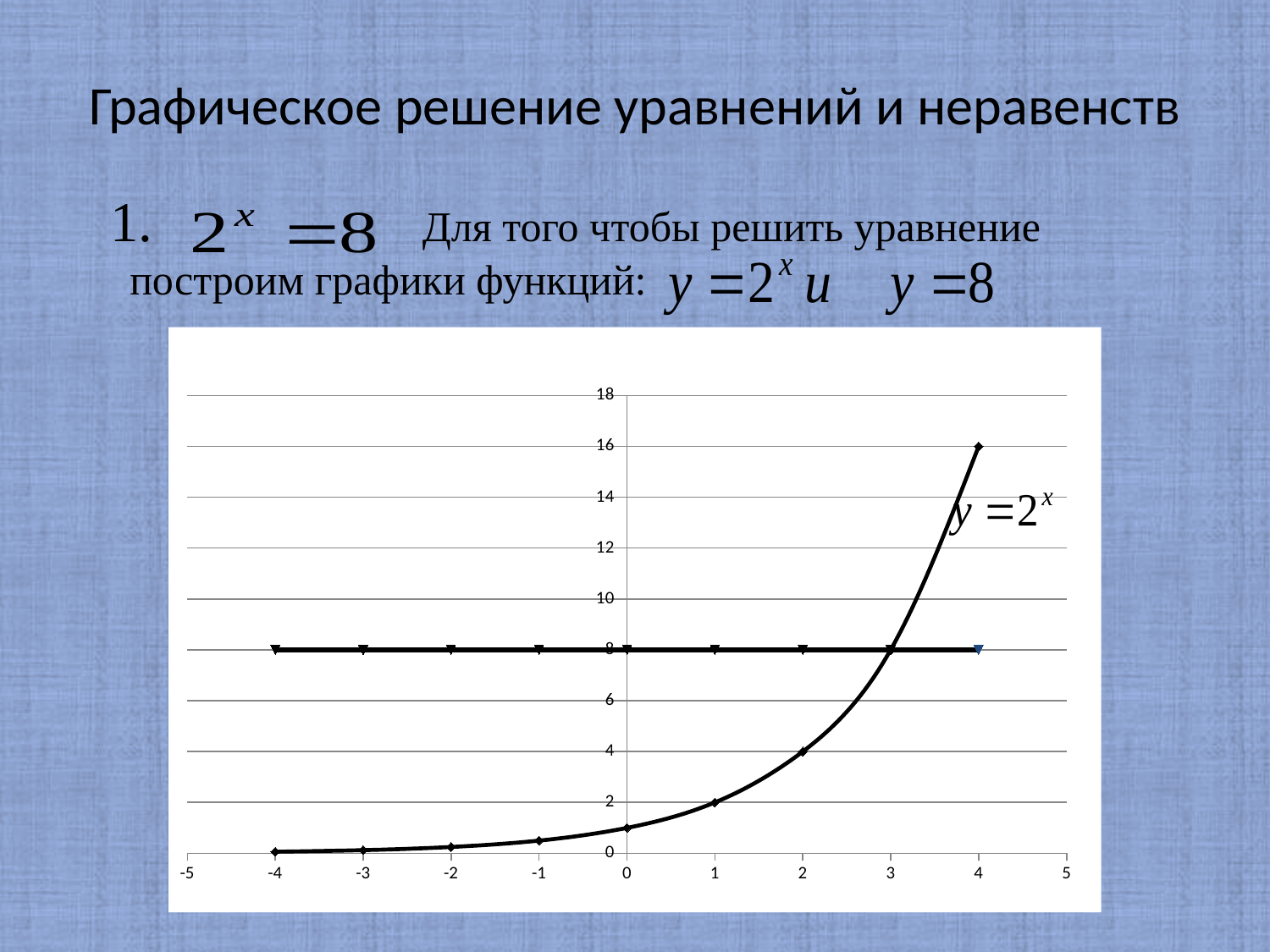
At which x value does the curve y = 2^x cross the horizontal line? 3 What is the value of the curve y = 2^x at x = 3? 8 How many marked points does the curve y = 2^x have? 9 Is the value of the curve y = 2^x at x = 0 greater or less than 2? less What is the value of the curve y = 2^x at x = 2? 4 What is the value of the curve y = 2^x at x = 4? 16 What kind of chart is shown on the slide? line chart Is the value of the curve y = 2^x at x = -4 greater or less than 2? less At what y value does the horizontal line run? 8 At x = 4, which is larger: the curve y = 2^x or the horizontal line? the curve y = 2^x What is the difference between the curve y = 2^x and the horizontal line at x = 4? 8 Does the curve y = 2^x rise or fall as x increases? rises